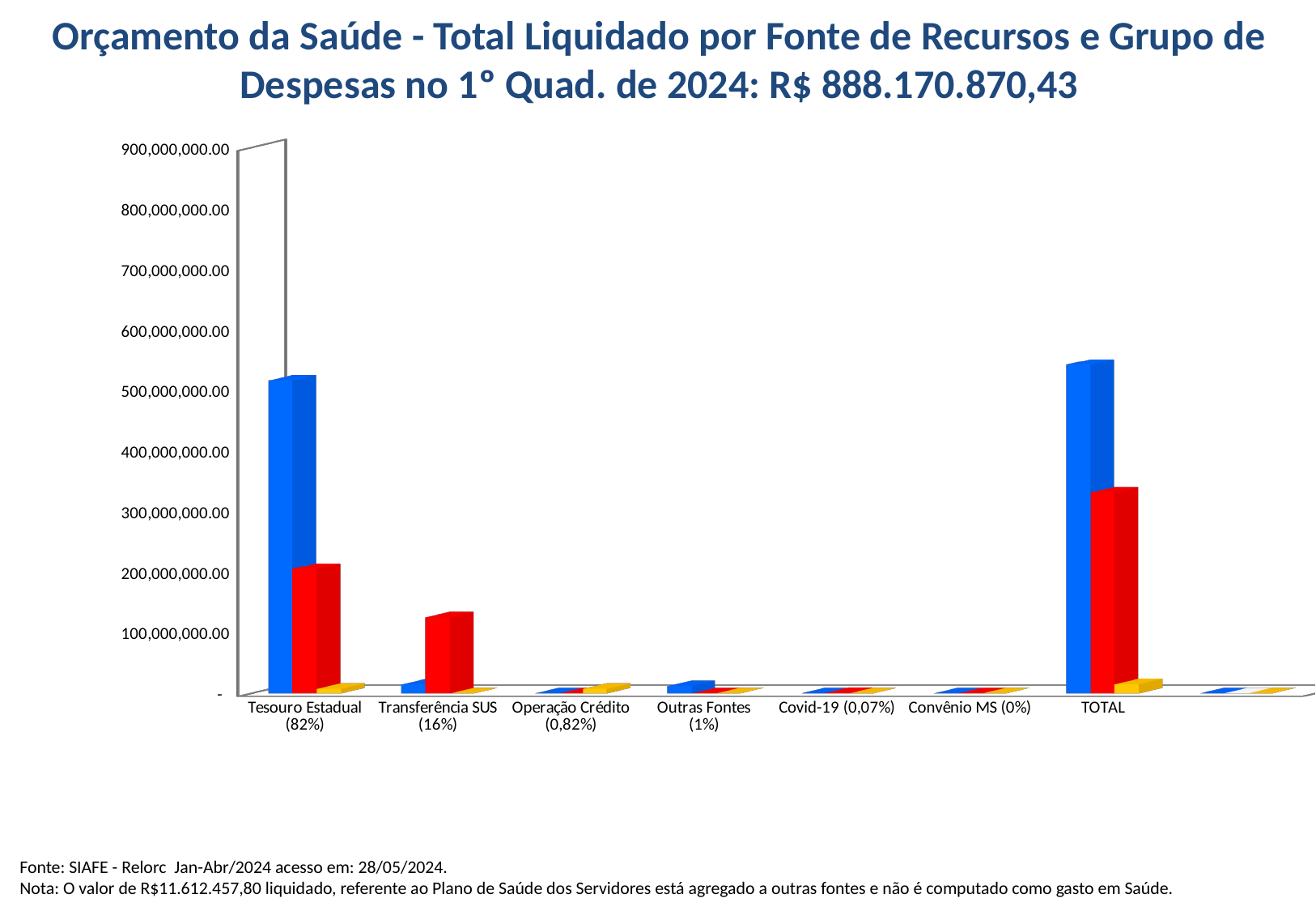
How many labelled categories are shown on the x axis? 7 Is the blue bar for Tesouro Estadual greater or less than 400,000,000.00? greater Is the red bar for Tesouro Estadual greater or less than 100,000,000.00? greater For Transferência SUS, which is larger, the blue bar or the red bar? the red bar Excluding TOTAL, which funding source has the tallest blue bar? Tesouro Estadual (82%) Is the red bar for Transferência SUS greater or less than 100,000,000.00? greater What kind of chart is shown on the slide? bar chart For Tesouro Estadual, which is larger, the blue bar or the red bar? the blue bar What total amount is stated in the chart title? R$ 888.170.870,43 Which category has the tallest blue bar? TOTAL